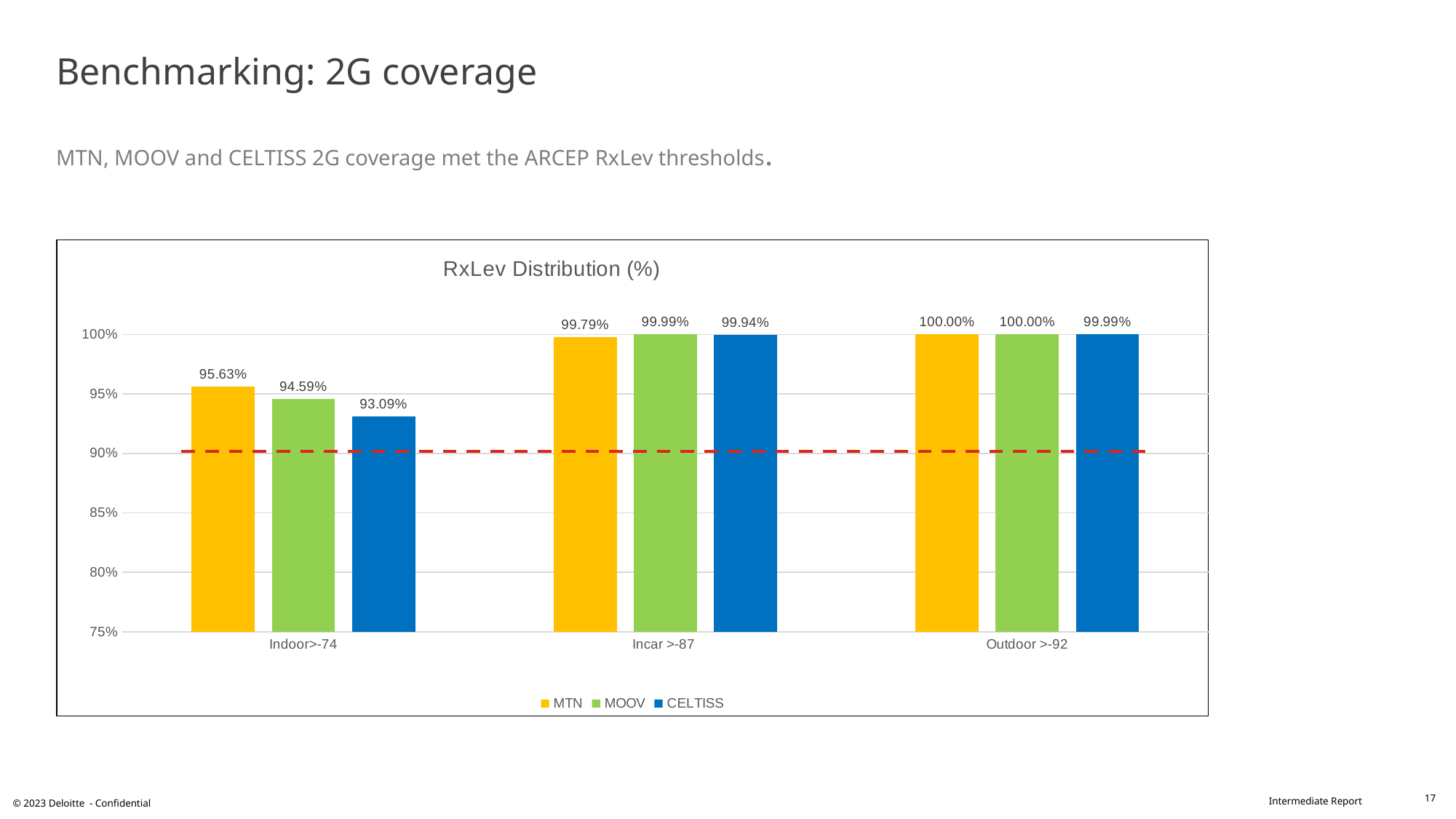
Which operator has the lowest value in the Indoor>-74 category? CELTISS What is the title of the chart? RxLev Distribution (%) What is the value for CELTISS in the Incar >-87 category? 99.94% Which is larger in the Incar >-87 category: MTN or MOOV? MOOV What is the value for MTN in the Indoor>-74 category? 95.63% How many categories are shown on the x axis? 3 What kind of chart is shown on the slide? Bar chart Which operator has the highest value in the Indoor>-74 category? MTN Is the value for CELTISS in the Indoor>-74 category greater or less than 90%? greater How many series does the legend list? 3 What is the difference between MTN and CELTISS in the Indoor>-74 category? 2.54% What is the value for MOOV in the Outdoor >-92 category? 100.00%